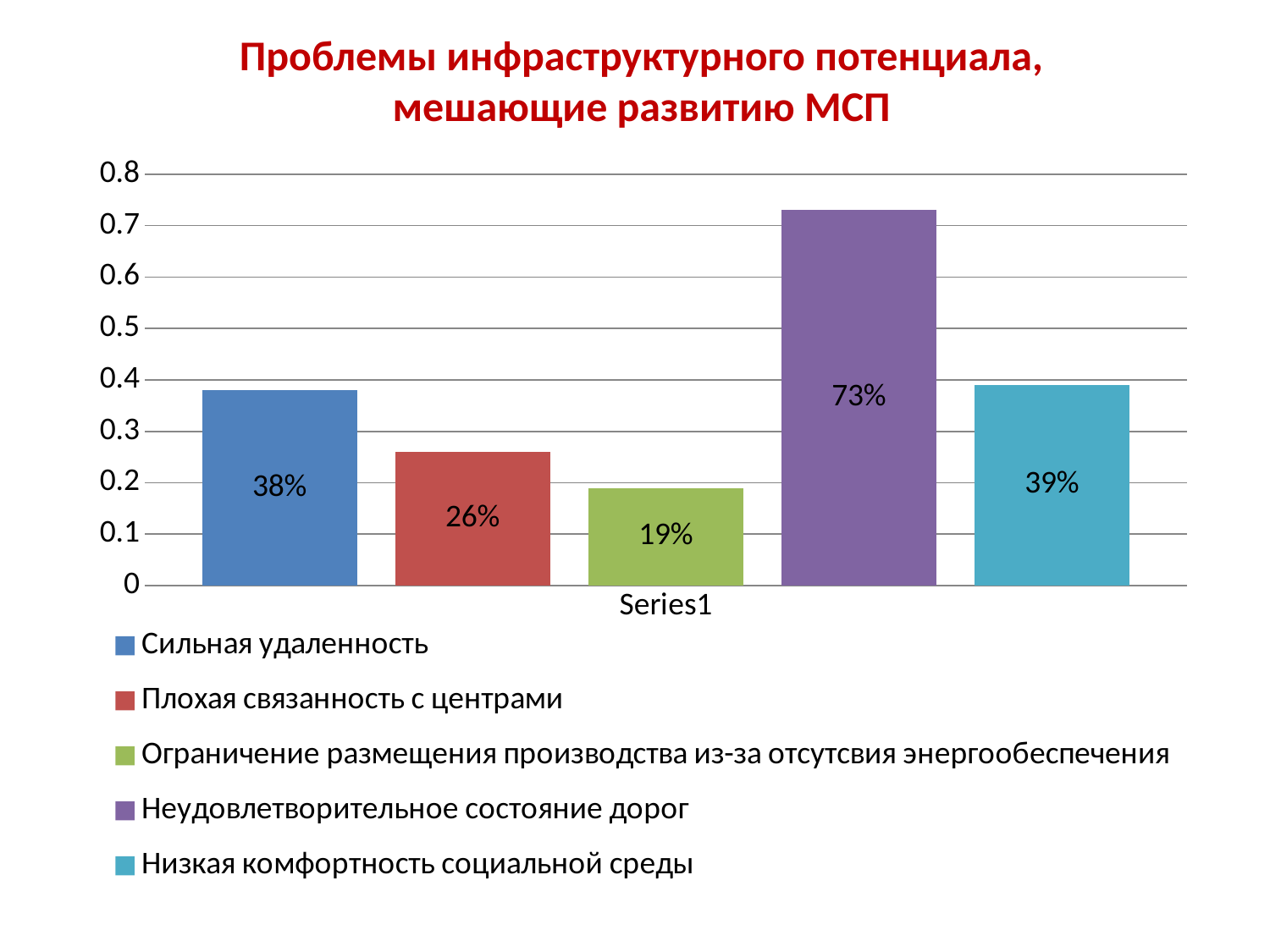
What is the title of the chart? Проблемы инфраструктурного потенциала, мешающие развитию МСП What is the difference between the values for Неудовлетворительное состояние дорог and Низкая комфортность социальной среды? 34% What is the value for Плохая связанность с центрами? 26% What is the value for Сильная удаленность? 38% What kind of chart is shown on the slide? Bar chart What is the value for Неудовлетворительное состояние дорог? 73% Which category has the highest value? Неудовлетворительное состояние дорог Which category has the lowest value? Ограничение размещения производства из-за отсутсвия энергообеспечения What is the value for Низкая комфортность социальной среды? 39% Which is larger, the value for Сильная удаленность or the value for Плохая связанность с центрами? Сильная удаленность How many entries does the legend list? 5 What is the value for Ограничение размещения производства из-за отсутсвия энергообеспечения? 19%